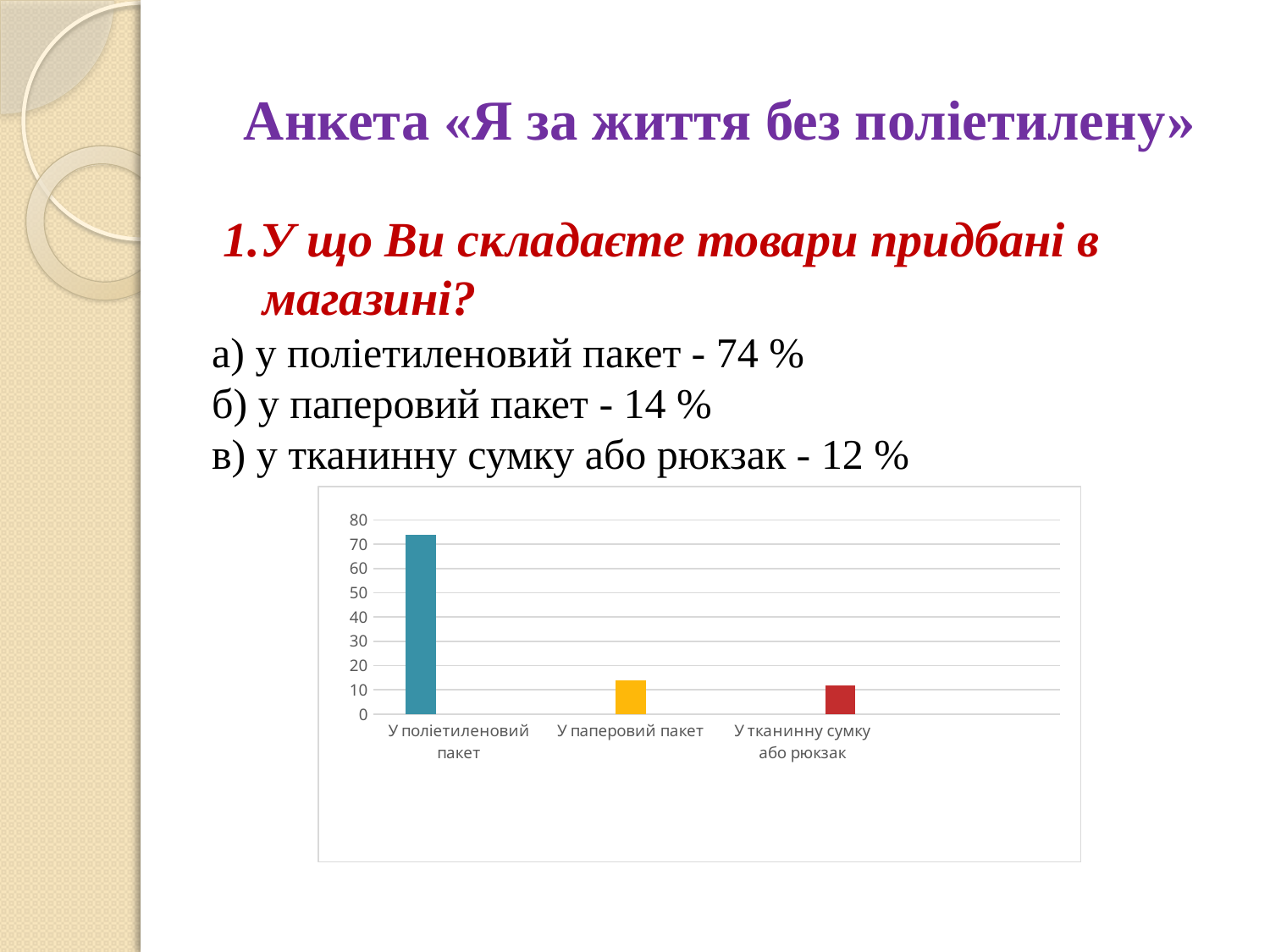
Which category has the highest bar in the chart? У поліетиленовий пакет According to the slide, what percentage of respondents put their purchases in a polyethylene bag (у поліетиленовий пакет)? 74 % What kind of chart is shown on the slide? bar chart How many categories are shown on the x axis of the chart? 3 Which category has the lowest bar in the chart? У тканинну сумку або рюкзак Is the value for У тканинну сумку або рюкзак greater or less than 10? greater What colour is the bar for У паперовий пакет? yellow What is the difference between the percentage for у поліетиленовий пакет and у паперовий пакет, using the values printed on the slide? 60 % According to the slide, what percentage of respondents use a paper bag (у паперовий пакет)? 14 % Is the value for У паперовий пакет greater or less than 20? less Is the value for У поліетиленовий пакет greater or less than 70? greater Which is larger, the value for У поліетиленовий пакет or the value for У паперовий пакет? У поліетиленовий пакет